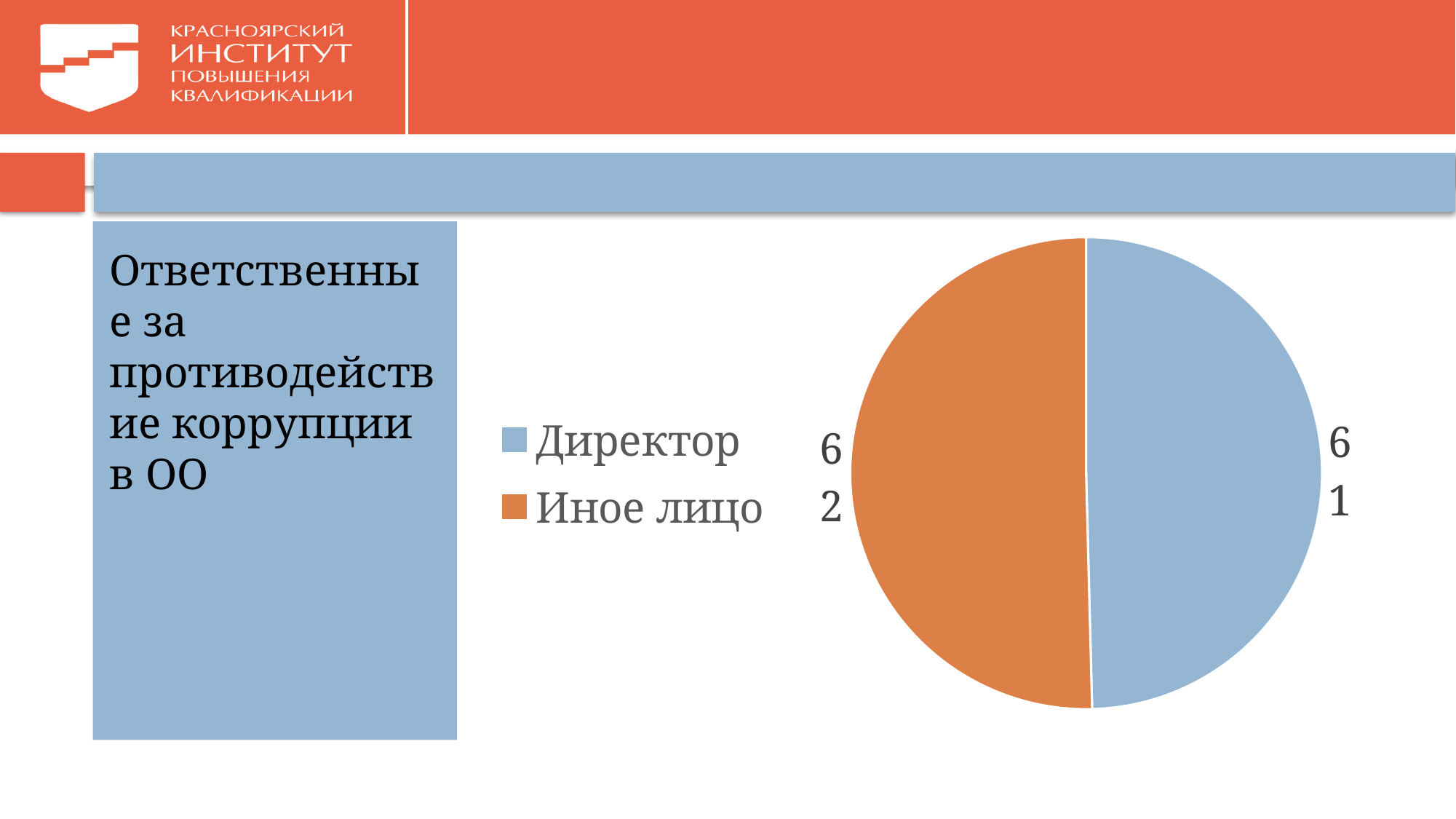
What is the difference between the values for Иное лицо and Директор? 1 How many slices does the pie chart have? 2 What colour is the Директор slice in the pie chart? blue Which category has the lowest value in the pie chart? Директор What is the total of the two values shown in the pie chart? 123 What is the value for Иное лицо in the pie chart? 62 What kind of chart is shown on the slide? pie chart How many entries does the legend of the pie chart list? 2 Which category has the highest value in the pie chart? Иное лицо Which category has the larger value according to the data labels, Директор or Иное лицо? Иное лицо What is the value for Директор in the pie chart? 61 What is the title shown next to the pie chart? Ответственные за противодействие коррупции в ОО